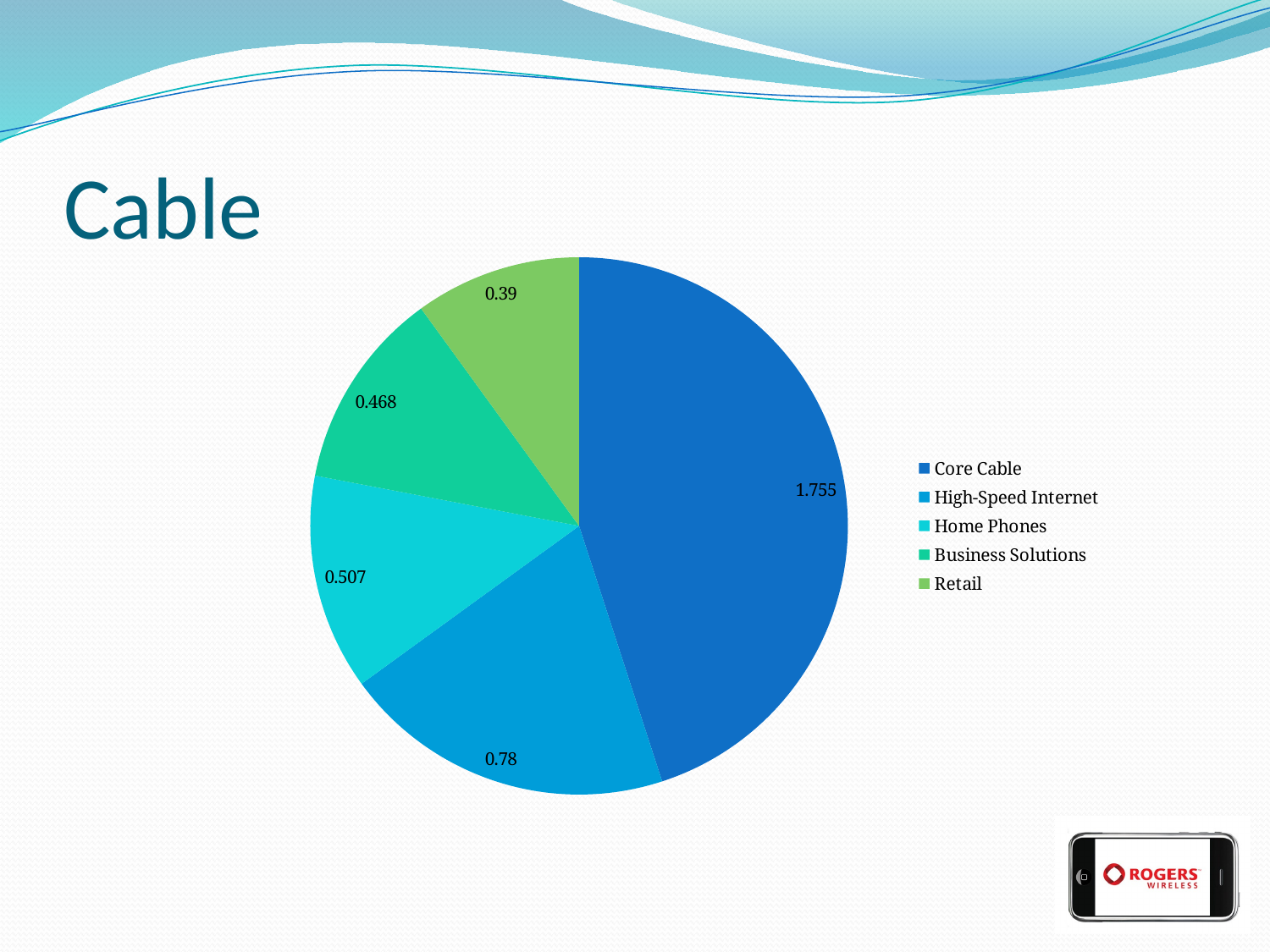
What is the value of the Home Phones slice? 0.507 Which category has the largest slice of the pie? Core Cable Which category has the smallest slice of the pie? Retail What is the value of the Retail slice? 0.39 What is the value of the High-Speed Internet slice? 0.78 What type of chart is shown on the slide? Pie chart What is the difference between the Core Cable value and the High-Speed Internet value? 0.975 Which is larger, Home Phones or Business Solutions? Home Phones What is the value of the Business Solutions slice? 0.468 What is the value of the Core Cable slice in the pie chart? 1.755 What share of the pie does the Core Cable slice represent? 45% How many categories does the pie chart show? 5